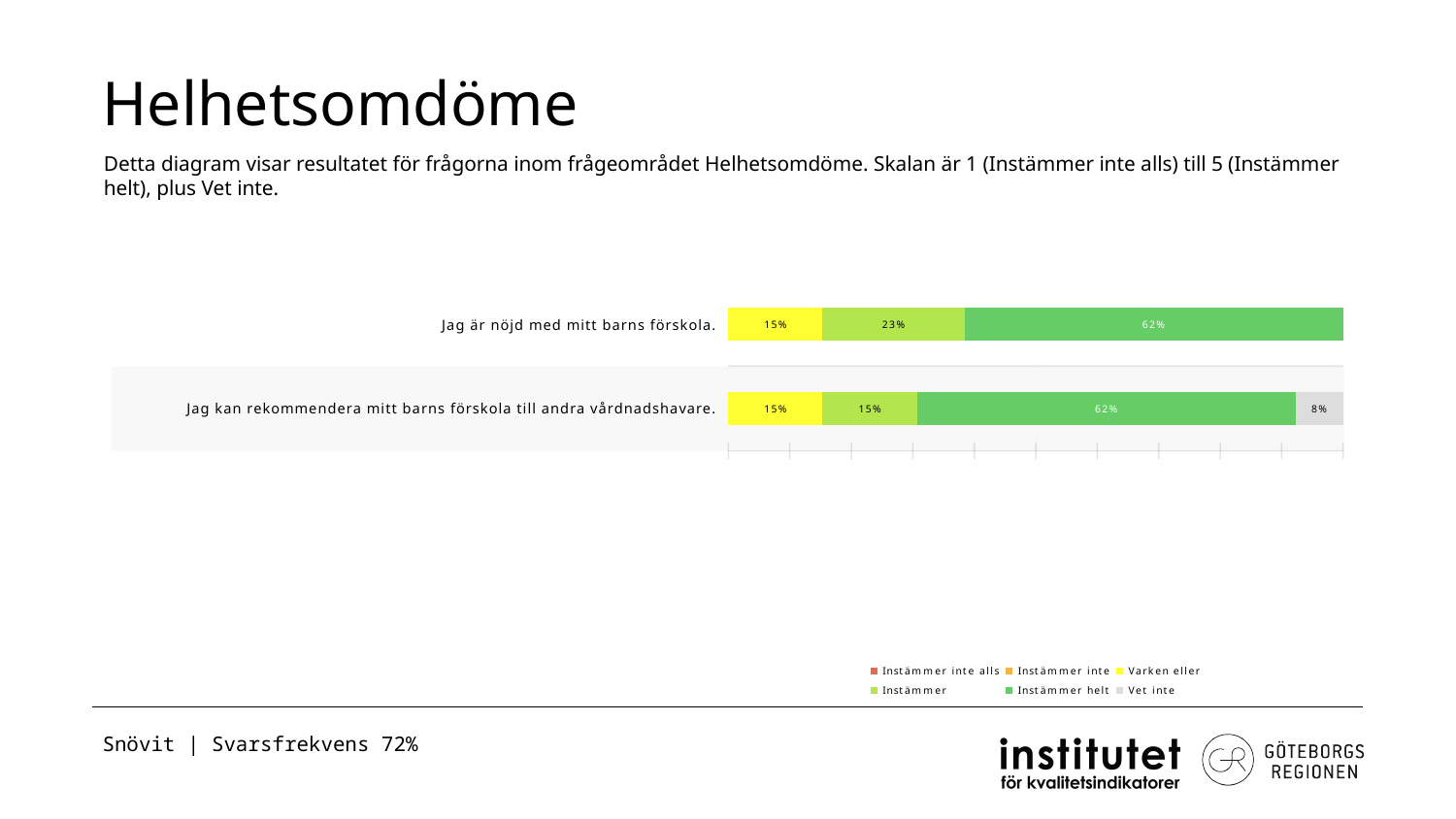
What is the total of the labelled segments for 'Jag är nöjd med mitt barns förskola.'? 100% How many categories (statements) does the chart show? 2 What is the 'Instämmer helt' value for 'Jag är nöjd med mitt barns förskola.'? 62% What is the 'Vet inte' value for 'Jag kan rekommendera mitt barns förskola till andra vårdnadshavare.'? 8% What is the 'Instämmer' value for 'Jag kan rekommendera mitt barns förskola till andra vårdnadshavare.'? 15% Which legend entry is shown in grey? Vet inte What is the 'Varken eller' value for 'Jag kan rekommendera mitt barns förskola till andra vårdnadshavare.'? 15% Which statement has the larger 'Instämmer' value? Jag är nöjd med mitt barns förskola. What is the difference between the 'Instämmer' values of the two statements? 8% How many series does the legend list? 6 What kind of chart is shown on the slide? stacked bar chart What is the 'Instämmer' value for 'Jag är nöjd med mitt barns förskola.'? 23%